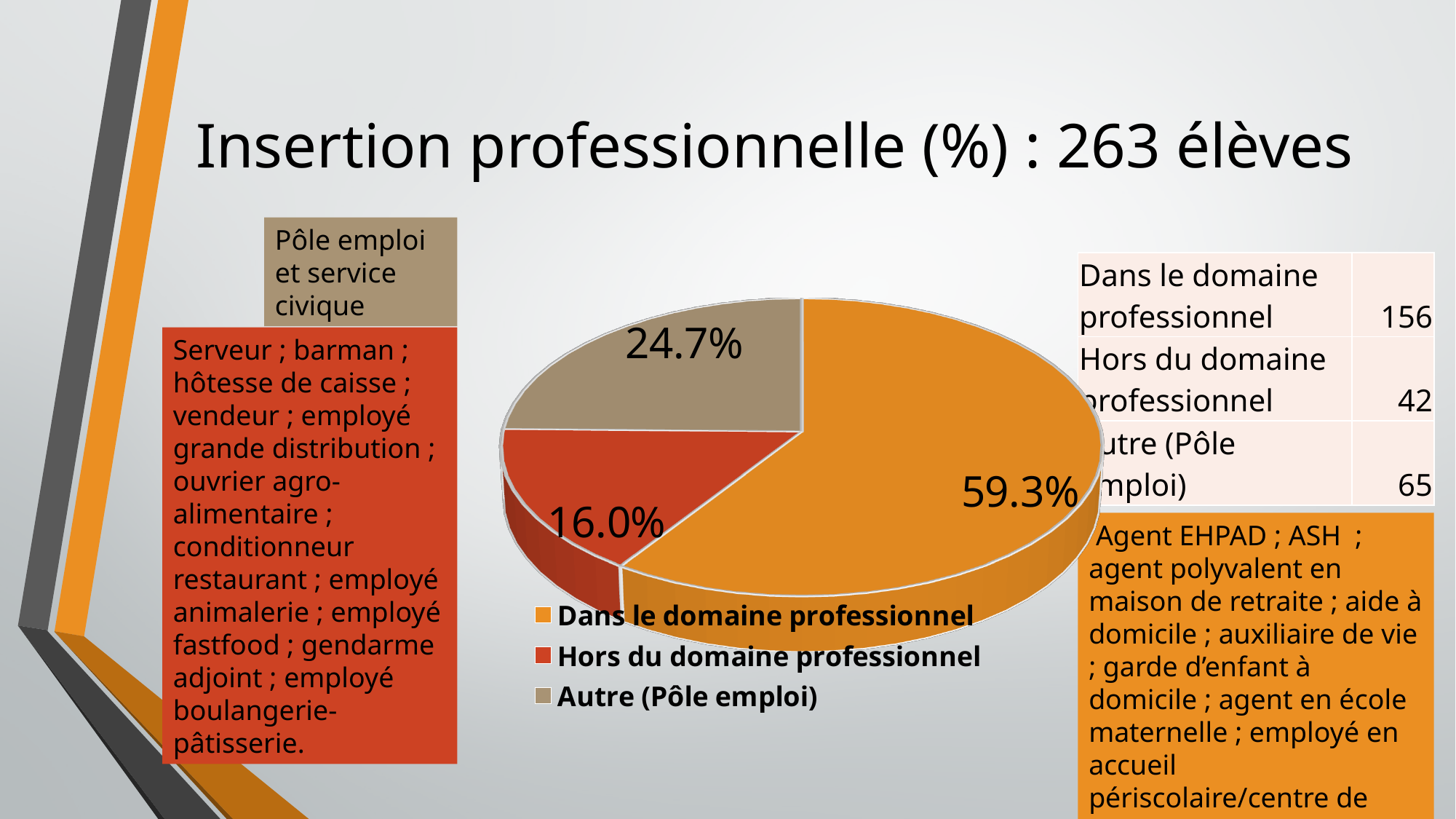
What is the title of the slide containing the pie chart? Insertion professionnelle (%) : 263 élèves Which category has the largest slice of the pie? Dans le domaine professionnel Which slice is larger: "Autre (Pôle emploi)" or "Hors du domaine professionnel"? Autre (Pôle emploi) What colour is the "Autre (Pôle emploi)" slice in the pie chart? brown/beige How many entries does the legend list? 3 How many slices does the pie chart have? 3 What percentage of the pie is labelled for "Hors du domaine professionnel"? 16.0% What percentage of the pie is labelled for "Autre (Pôle emploi)"? 24.7% What percentage of the pie is labelled for "Dans le domaine professionnel"? 59.3% What is the difference in percentage points between the "Dans le domaine professionnel" slice and the "Autre (Pôle emploi)" slice? 34.6 What type of chart is shown on the slide? pie chart Which category has the smallest slice of the pie? Hors du domaine professionnel